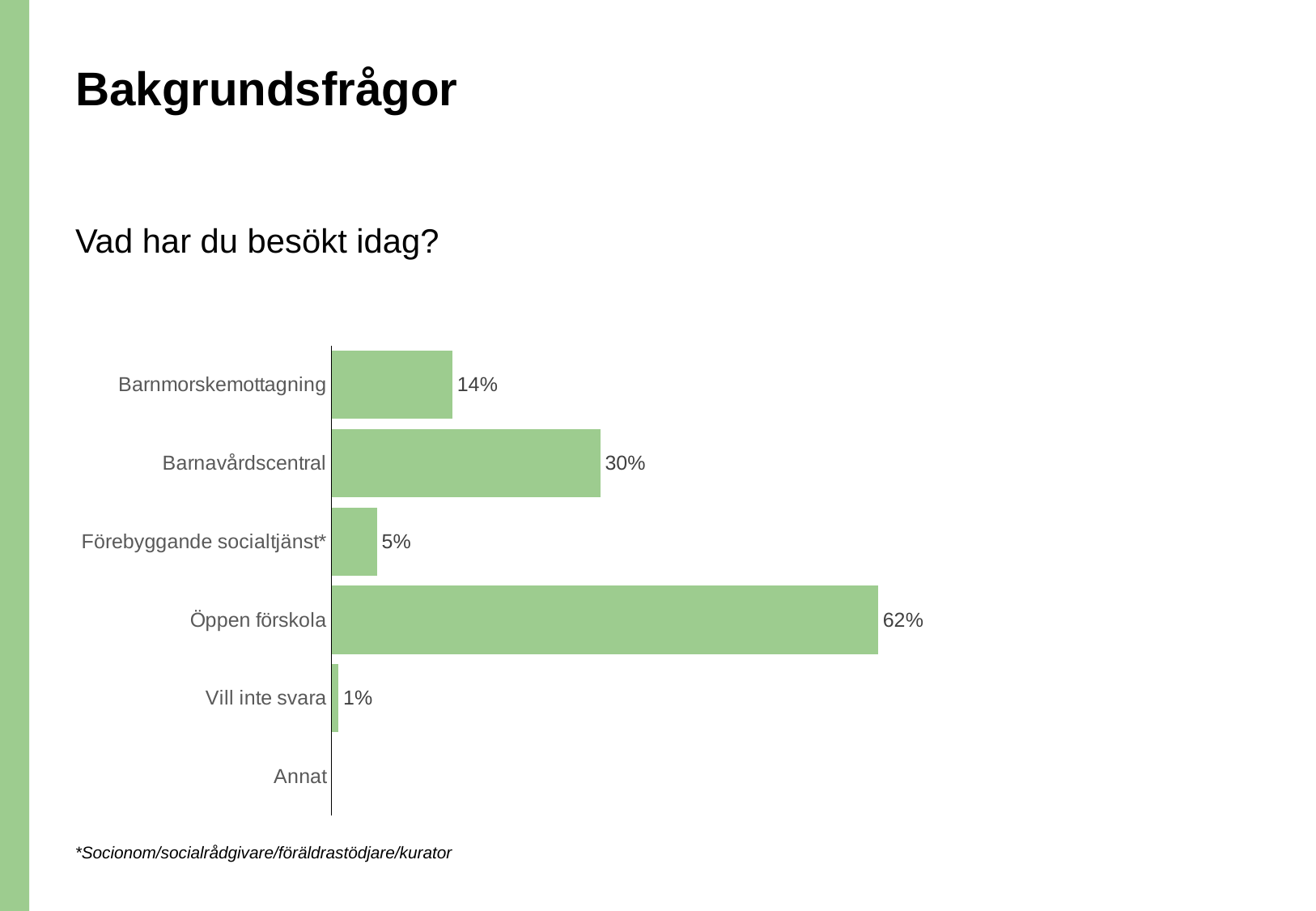
What percentage chose Vill inte svara? 1% What question does the chart answer, according to the text above it? Vad har du besökt idag? What is the difference between Öppen förskola and Barnavårdscentral? 32% What percentage is shown for Barnmorskemottagning? 14% Which is larger, Barnmorskemottagning or Förebyggande socialtjänst*? Barnmorskemottagning What percentage of respondents visited Öppen förskola? 62% How many categories are listed on the chart? 6 What kind of chart is shown on the slide? Bar chart Which labelled bar has the lowest non-zero value? Vill inte svara What is the value for Förebyggande socialtjänst*? 5% What is the value shown for Barnavårdscentral? 30% Which category has the highest value? Öppen förskola